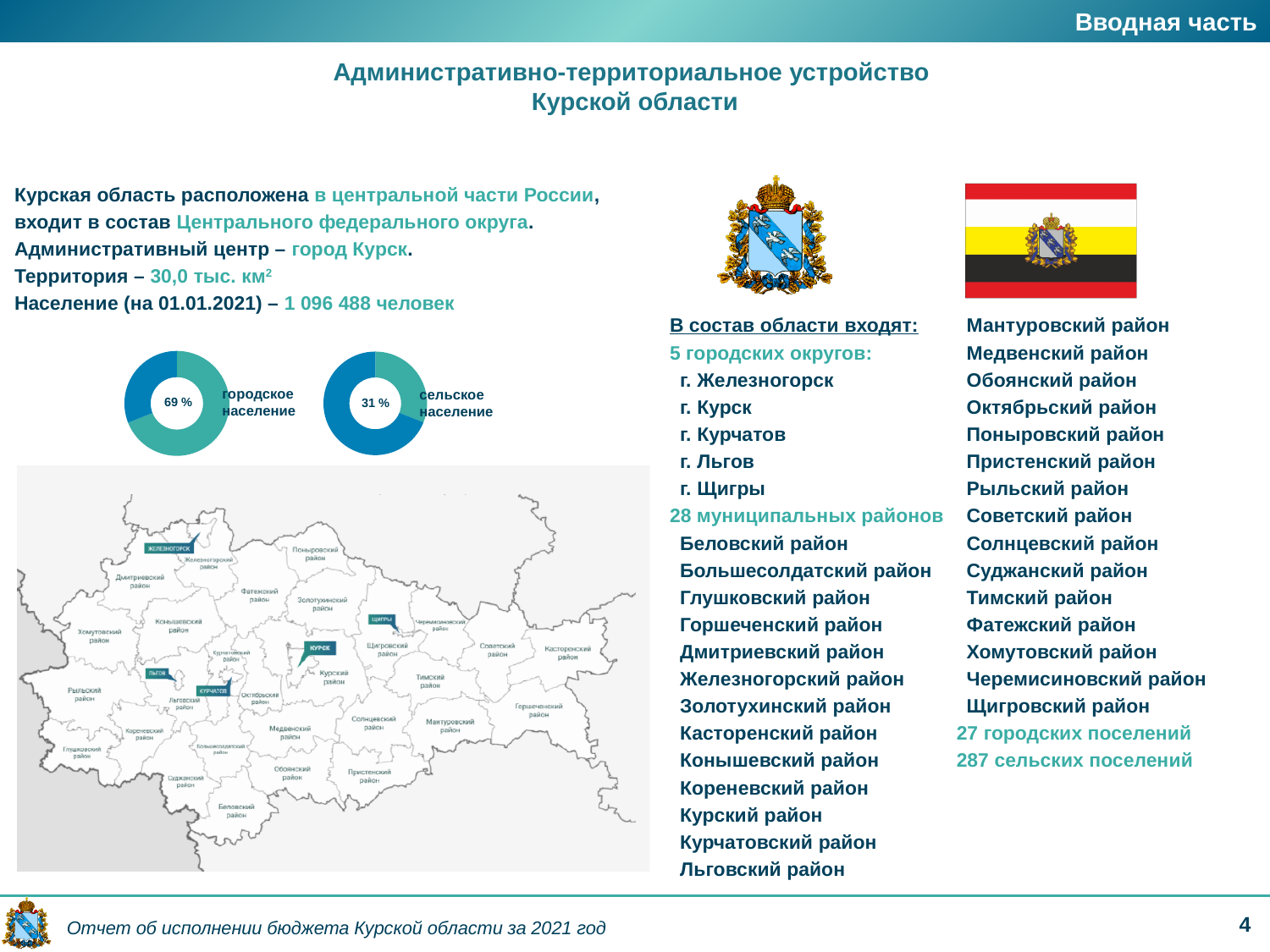
Which is larger, the urban population share or the rural population share? Urban population (городское население) Is the urban population share greater or less than 50%? greater What share of the population is shown as urban (городское население) in the left donut chart? 69 % Which population group has the smallest share in the donut charts? Rural population (сельское население) What label is written next to the left donut chart? городское население How many donut charts are shown on the slide? 2 What label is written next to the right donut chart? сельское население What do the urban and rural population shares in the two donut charts add up to? 100 % What kind of chart is used to show the urban and rural population shares? Donut (pie) chart By how many percentage points does the urban population share exceed the rural population share? 38 percentage points Is the rural population share greater or less than 50%? less What share of the population is shown as rural (сельское население) in the right donut chart? 31 %